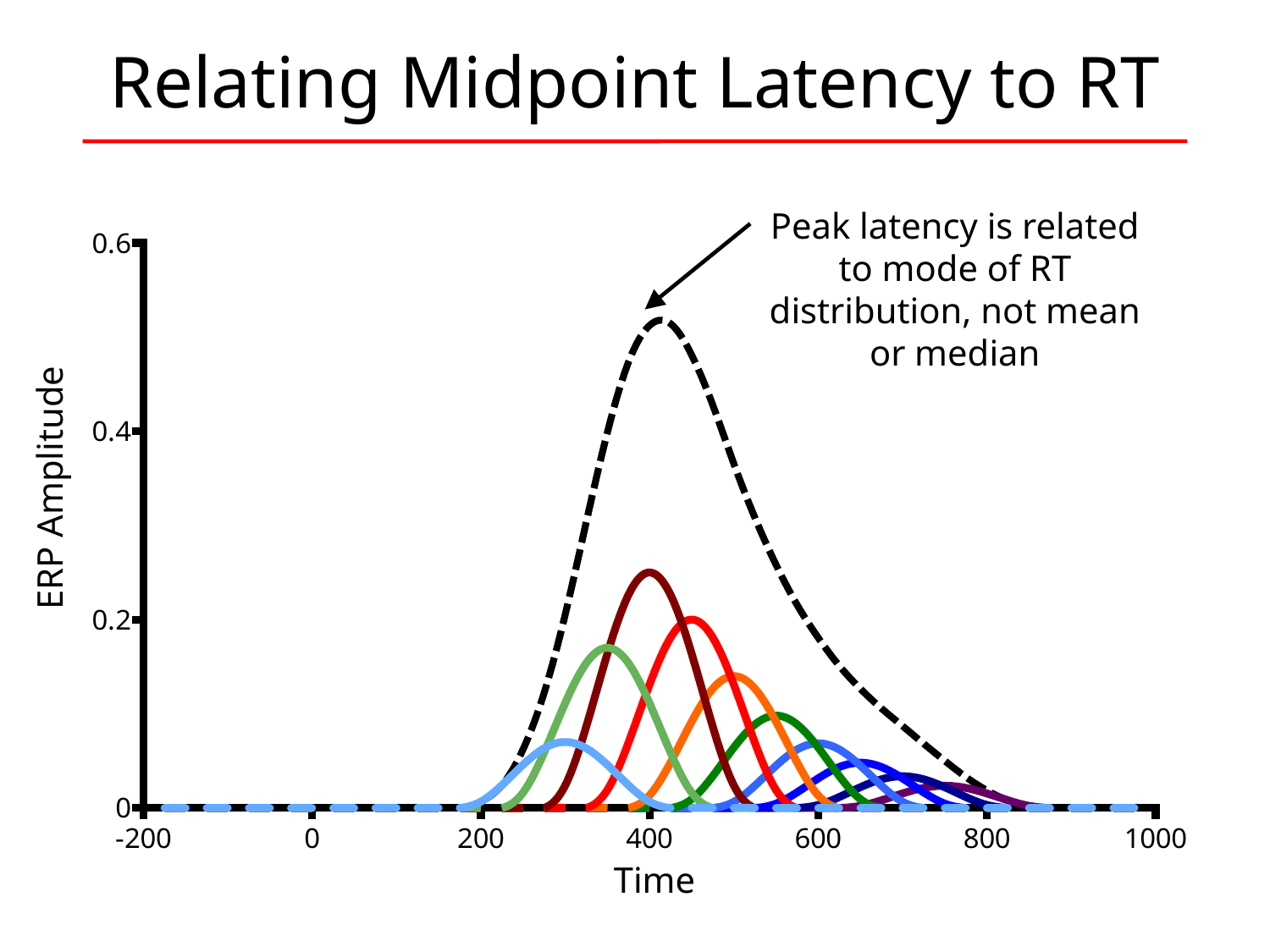
Which curve reaches the highest peak amplitude? the dashed black curve Is the peak of the orange curve greater or less than 0.2? less Which has the higher peak, the dark red curve or the light green curve? the dark red curve What is the label on the horizontal axis? Time Which has the higher peak, the dashed black curve or the dark red curve? the dashed black curve Does the dashed black curve peak at a time greater or less than 600? less What is the label on the vertical axis? ERP Amplitude What kind of chart is shown on the slide? line chart Is the peak of the dark red curve greater or less than 0.2? greater